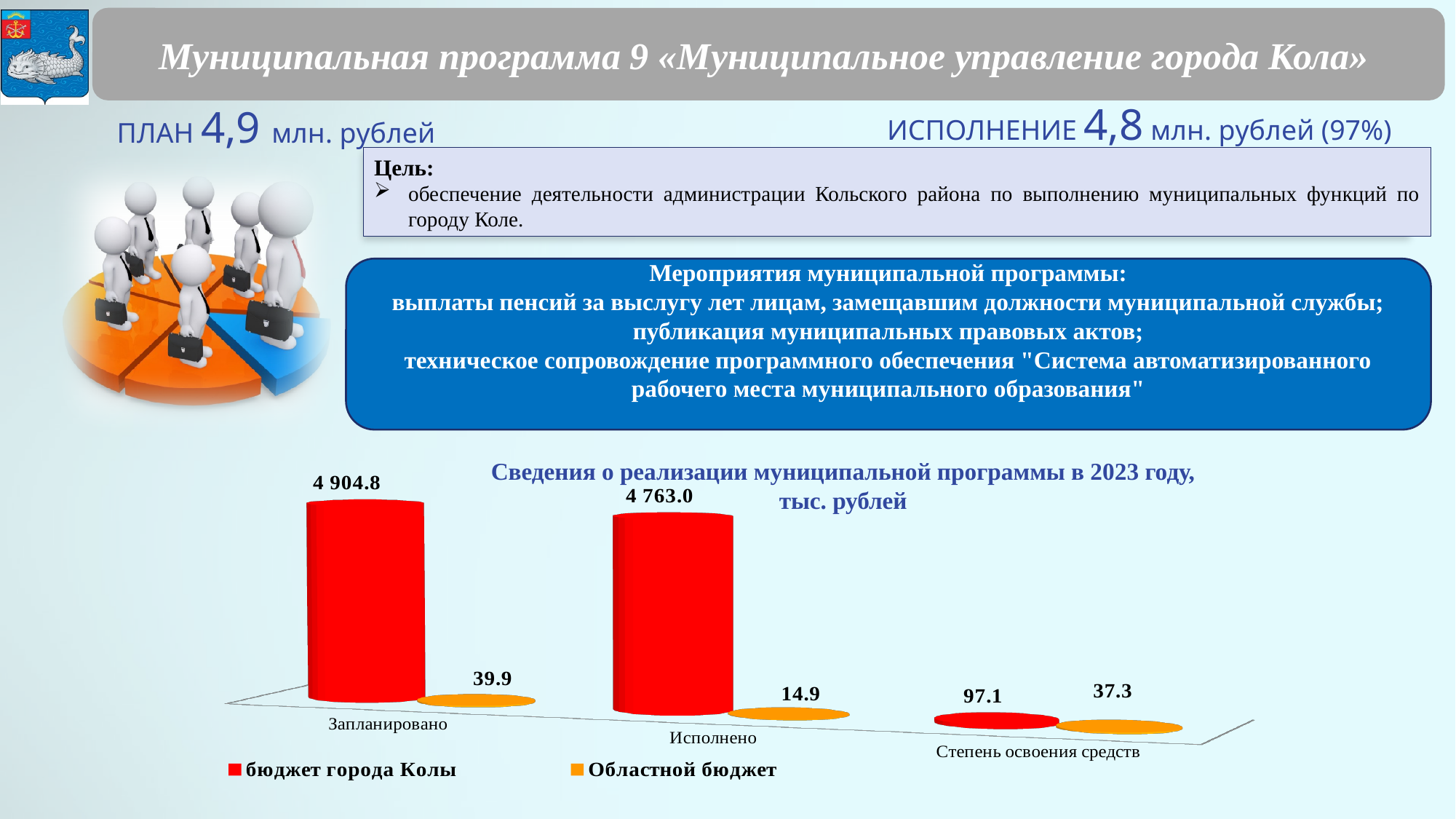
What is the difference between the planned («Запланировано») and executed («Исполнено») values for «бюджет города Колы»? 141.8 How many series does the chart legend list? 2 What is the value for «бюджет города Колы» in the «Степень освоения средств» category? 97.1 Which category has the highest value for «бюджет города Колы»? Запланировано What is the value for «Областной бюджет» in the «Запланировано» category? 39.9 Which is larger: «Областной бюджет» in «Запланировано» or «Областной бюджет» in «Степень освоения средств»? Запланировано Which category has the lowest value for «Областной бюджет»? Исполнено What type of chart is shown on the slide? Bar chart How many categories are shown on the x axis of the chart? 3 What is the difference between the «Запланировано» and «Исполнено» values for «Областной бюджет»? 25.0 What is the value for «Областной бюджет» in the «Исполнено» category? 14.9 What is the value for «бюджет города Колы» in the «Запланировано» category? 4 904.8